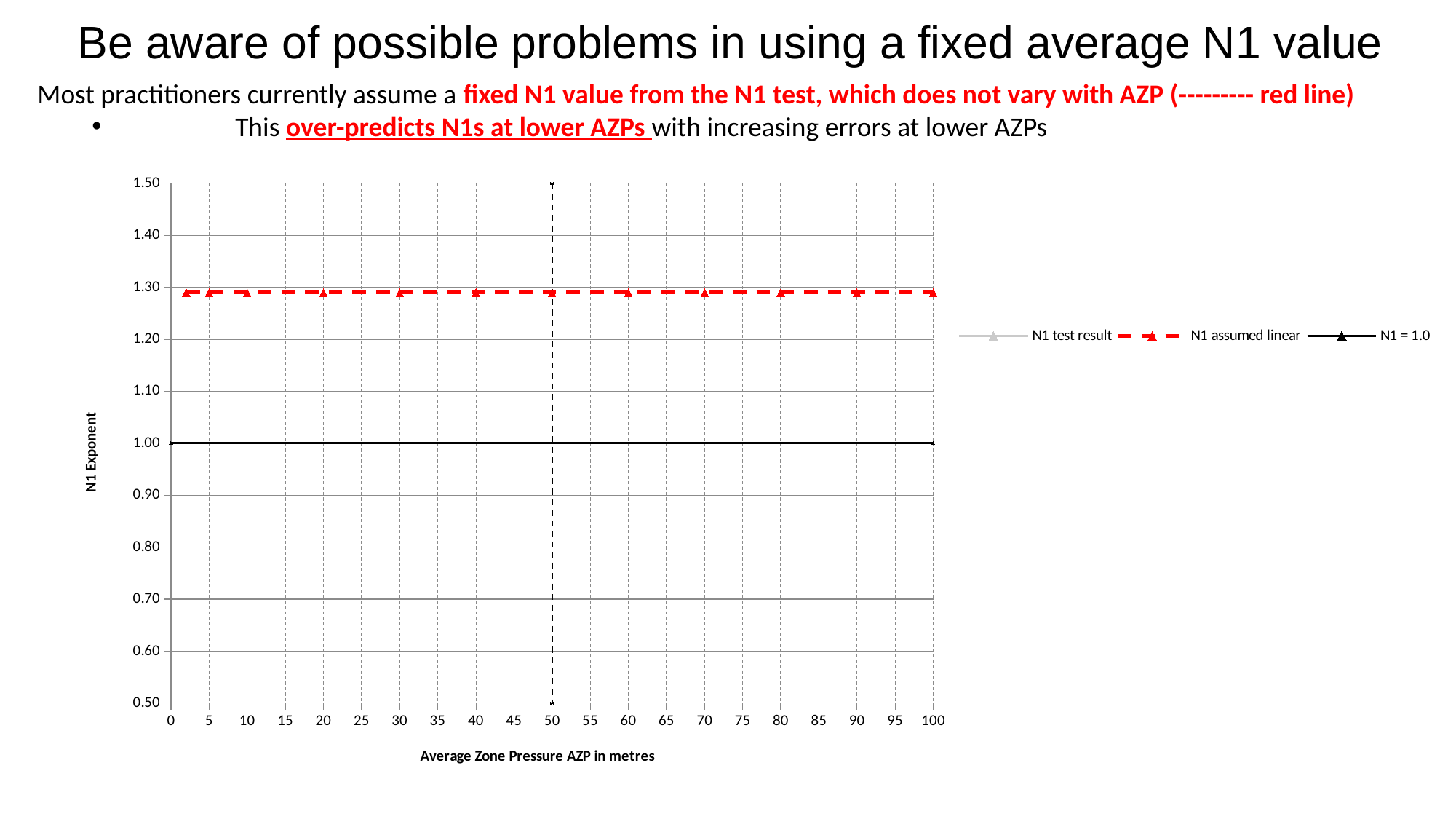
What is the lowest value shown on the y axis of the chart? 0.50 Which series has the higher value, 'N1 assumed linear' or 'N1 = 1.0'? N1 assumed linear Does the 'N1 assumed linear' line rise, fall, or stay constant as AZP increases from 0 to 100? stays constant At what AZP value is the vertical dashed line drawn on the chart? 50 Is the value of the red dashed 'N1 assumed linear' line greater or less than 1.40? less How many series does the chart legend list? 3 Is the value of the red dashed 'N1 assumed linear' line greater or less than 1.20? greater What are the three series named in the chart legend? N1 test result, N1 assumed linear, N1 = 1.0 What kind of chart is shown on the slide? line chart What value does the solid black 'N1 = 1.0' line sit at on the y axis? 1.00 What is the title of the chart's x axis? Average Zone Pressure AZP in metres What is the highest value shown on the y axis (N1 Exponent)? 1.50